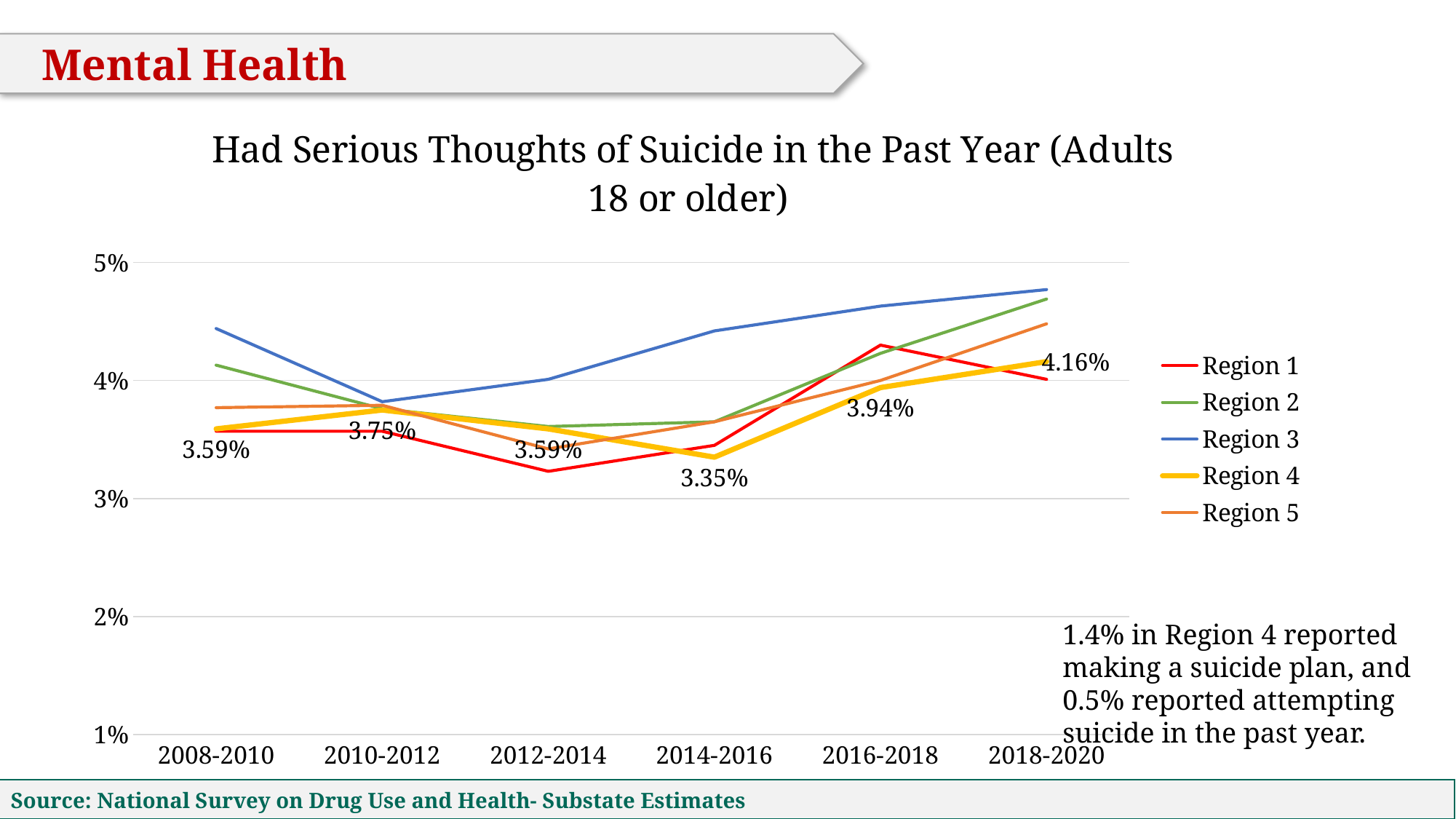
What kind of chart is shown on the slide? Line chart Is the value for Region 3 in 2018-2020 greater or less than 4%? greater What is the value for Region 4 in 2018-2020? 4.16% In which period is the Region 4 value lowest? 2014-2016 What is the value for Region 4 in 2008-2010? 3.59% Which region has the highest value in 2008-2010? Region 3 In which period is the Region 4 value highest? 2018-2020 What is the value for Region 4 in 2014-2016? 3.35% Which is larger for Region 4: the value in 2010-2012 or the value in 2014-2016? 2010-2012 Is the value for Region 1 in 2012-2014 greater or less than 4%? less What is the difference between the Region 4 values in 2018-2020 and 2014-2016? 0.81 percentage points How many series does the legend list? 5